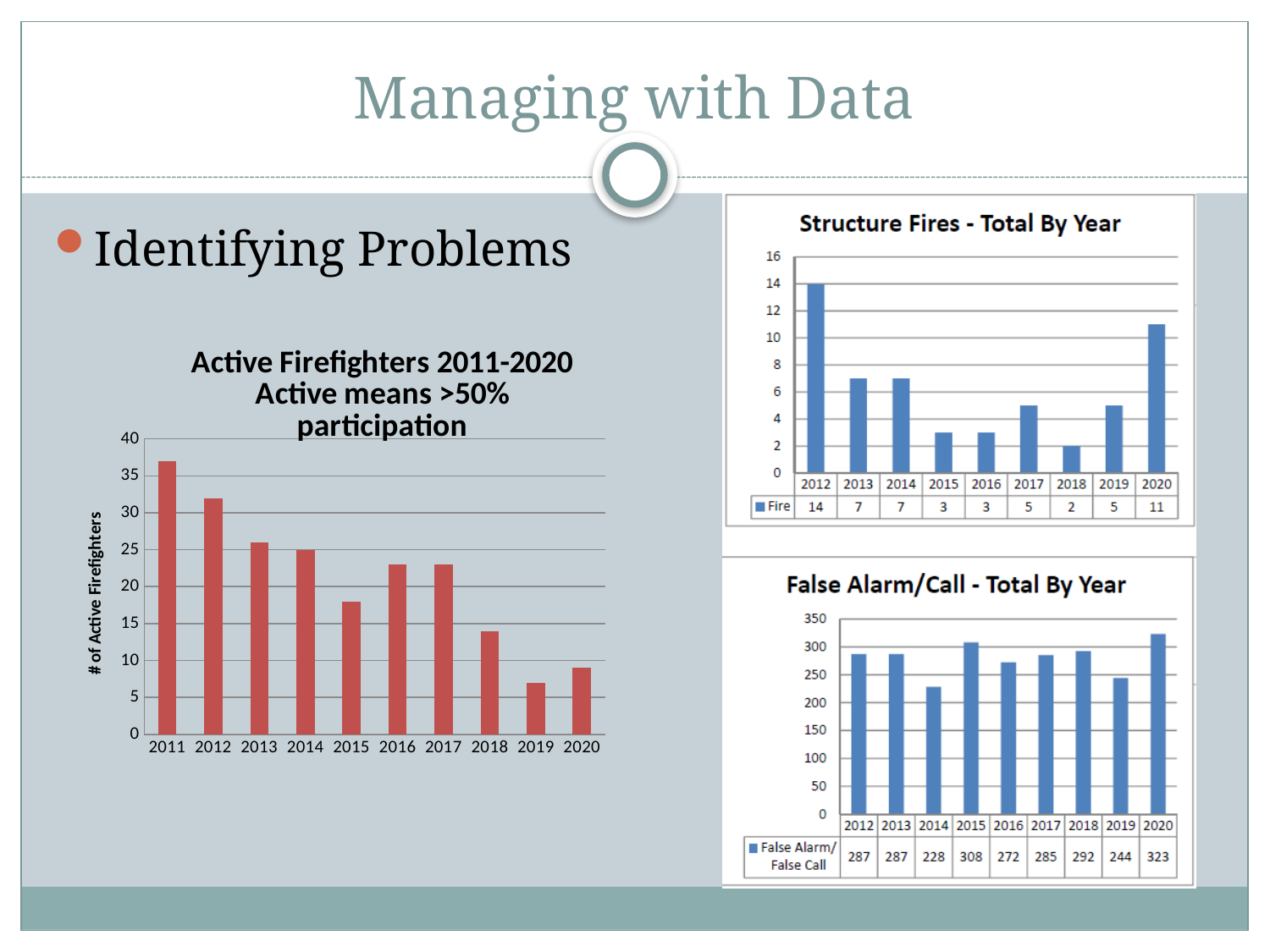
In the Active Firefighters 2011-2020 chart, which year has the highest number of active firefighters? 2011 In the Active Firefighters 2011-2020 chart, is the value for 2015 greater or less than 20? less In the False Alarm/Call - Total By Year chart, what is the value for 2015? 308 In the False Alarm/Call - Total By Year chart, which year had the lowest number of false alarms/calls? 2014 In the Structure Fires - Total By Year chart, how many structure fires were there in 2020? 11 In the Structure Fires - Total By Year chart, which year had the most structure fires? 2012 In the Structure Fires - Total By Year chart, what is the difference between the 2012 and 2018 values? 12 In the False Alarm/Call - Total By Year chart, which year had the highest value? 2020 In the Active Firefighters 2011-2020 chart, do the values generally rise or fall from 2011 to 2020? fall In the False Alarm/Call - Total By Year chart, what is the difference between the 2020 and 2019 values? 79 In the Structure Fires - Total By Year chart, which year had the fewest structure fires? 2018 In the Active Firefighters 2011-2020 chart, how many years are shown on the x axis? 10